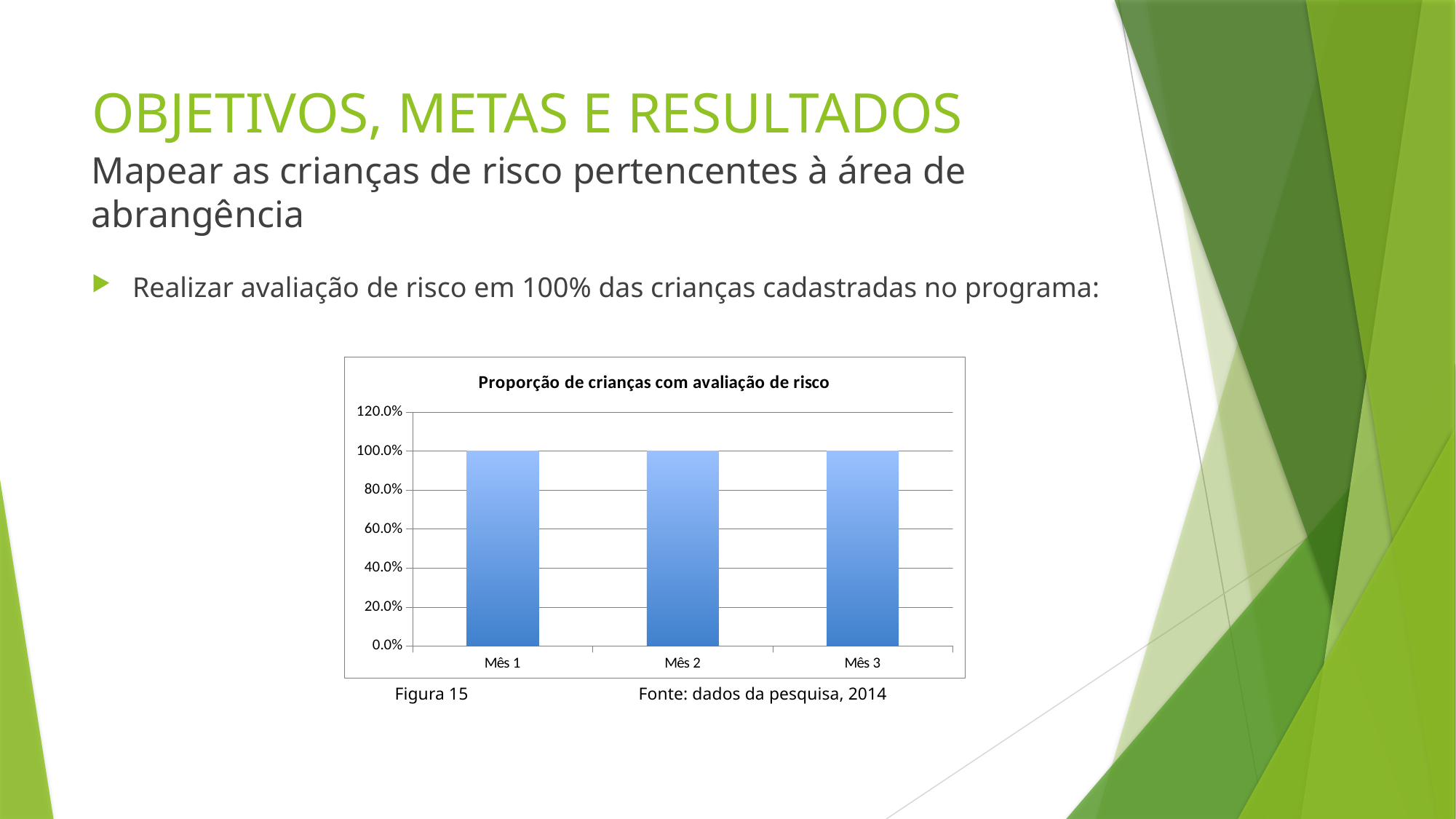
What kind of chart is shown on the slide? bar chart What figure number is given below the chart? Figura 15 Do the values rise, fall, or stay the same from Mês 1 to Mês 3? stay the same What is the value for Mês 1 in the chart? 100.0% What is the value for Mês 3 in the chart? 100.0% How many categories are shown on the x axis of the chart? 3 What is the difference between the values for Mês 1 and Mês 2? 0.0% Is the value for Mês 1 greater or less than 80.0%? greater Is the value for Mês 3 greater or less than 120.0%? less What is the title of the chart? Proporção de crianças com avaliação de risco What is the value for Mês 2 in the chart? 100.0%